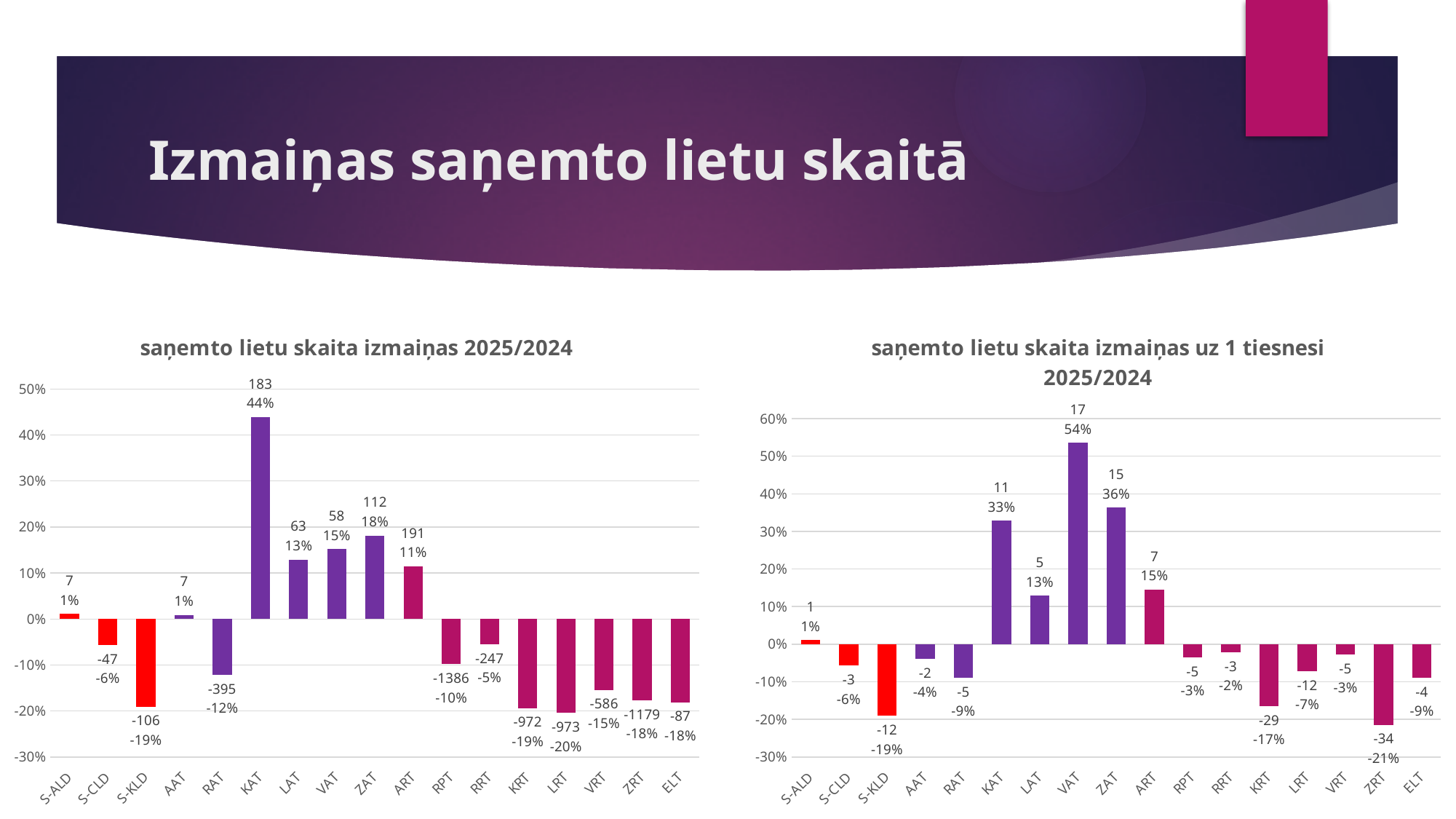
In the left chart 'saņemto lietu skaita izmaiņas 2025/2024', which category has the highest percentage change? KAT What type of chart is the left chart 'saņemto lietu skaita izmaiņas 2025/2024'? Bar chart In the right chart 'saņemto lietu skaita izmaiņas uz 1 tiesnesi 2025/2024', which category has the lowest percentage change? ZRT In the left chart 'saņemto lietu skaita izmaiņas 2025/2024', what percentage change is shown for KAT? 44% In the right chart 'saņemto lietu skaita izmaiņas uz 1 tiesnesi 2025/2024', which is larger, the percentage change for KAT or for ZAT? ZAT In the left chart 'saņemto lietu skaita izmaiņas 2025/2024', what is the difference in percentage points between ZAT (18%) and LAT (13%)? 5 percentage points In the left chart 'saņemto lietu skaita izmaiņas 2025/2024', which category has the lowest percentage change? LRT In the right chart 'saņemto lietu skaita izmaiņas uz 1 tiesnesi 2025/2024', which category has the highest percentage change? VAT In the left chart 'saņemto lietu skaita izmaiņas 2025/2024', what is the number shown above the bar for RPT? -1386 In the left chart 'saņemto lietu skaita izmaiņas 2025/2024', how many categories are shown on the x axis? 17 In the right chart 'saņemto lietu skaita izmaiņas uz 1 tiesnesi 2025/2024', what percentage change is shown for VAT? 54% In the right chart 'saņemto lietu skaita izmaiņas uz 1 tiesnesi 2025/2024', what is the number shown for ZRT? -34